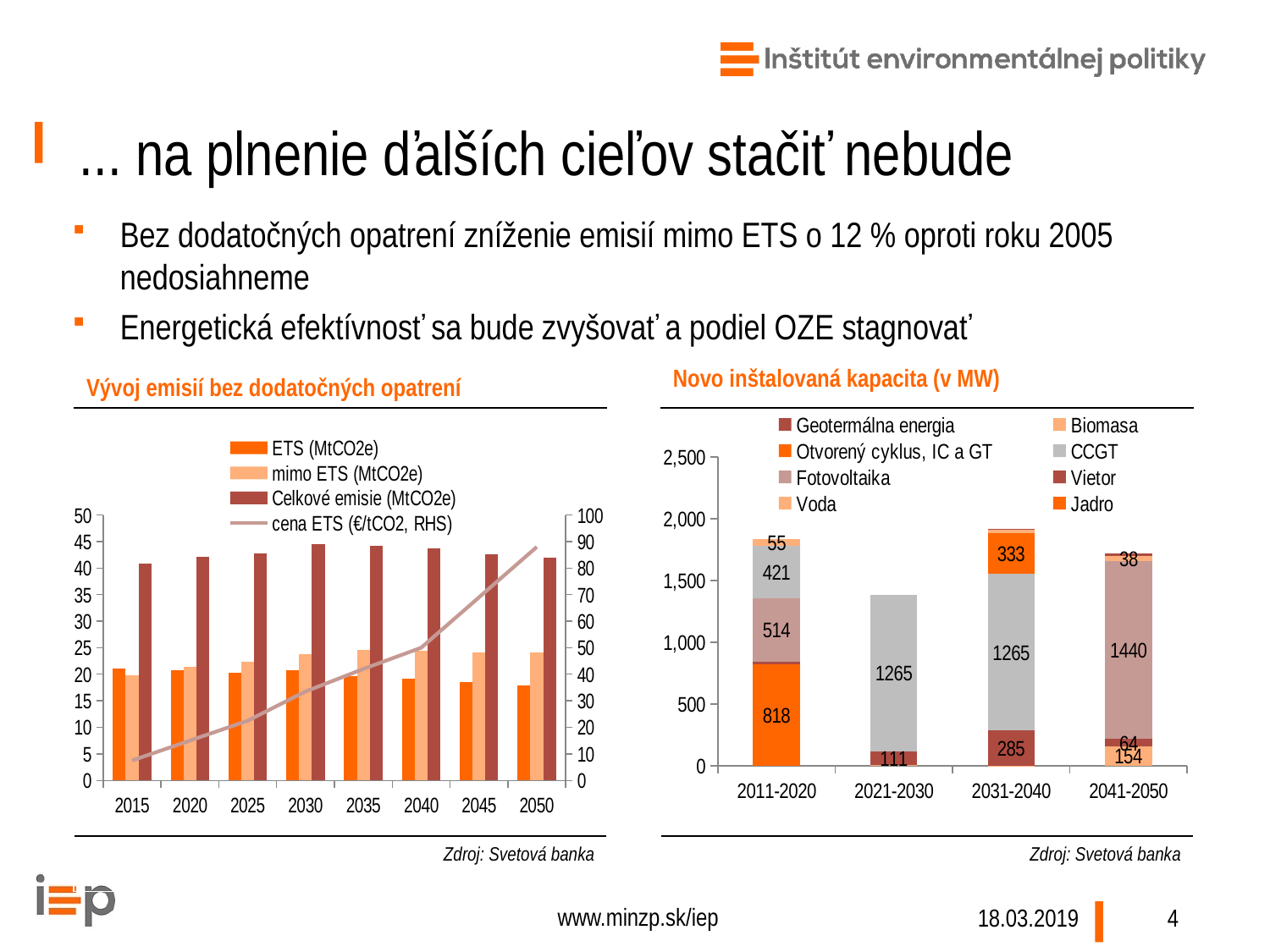
In the chart 'Novo inštalovaná kapacita (v MW)', what is the value for Otvorený cyklus, IC a GT in 2031-2040? 333 In the chart 'Novo inštalovaná kapacita (v MW)', what is the difference between the Fotovoltaika value in 2041-2050 and in 2011-2020? 926 In the chart 'Vývoj emisií bez dodatočných opatrení', does the line 'cena ETS (€/tCO2, RHS)' rise or fall from 2015 to 2050? Rises How many periods are shown on the x axis of the chart 'Novo inštalovaná kapacita (v MW)'? 4 In the chart 'Novo inštalovaná kapacita (v MW)', what is the value for CCGT in 2021-2030? 1265 In the chart 'Novo inštalovaná kapacita (v MW)', what is the value for Fotovoltaika in 2041-2050? 1440 In the chart 'Vývoj emisií bez dodatočných opatrení', is the value for Celkové emisie (MtCO2e) in 2030 greater or less than 40? greater What kind of chart is 'Novo inštalovaná kapacita (v MW)'? Stacked bar chart In the chart 'Vývoj emisií bez dodatočných opatrení', how many years are shown on the x axis? 8 How many series does the legend of the chart 'Novo inštalovaná kapacita (v MW)' list? 8 In the chart 'Novo inštalovaná kapacita (v MW)', what is the value for Jadro in 2011-2020? 818 In the chart 'Novo inštalovaná kapacita (v MW)', which period has the lowest total newly installed capacity? 2021-2030